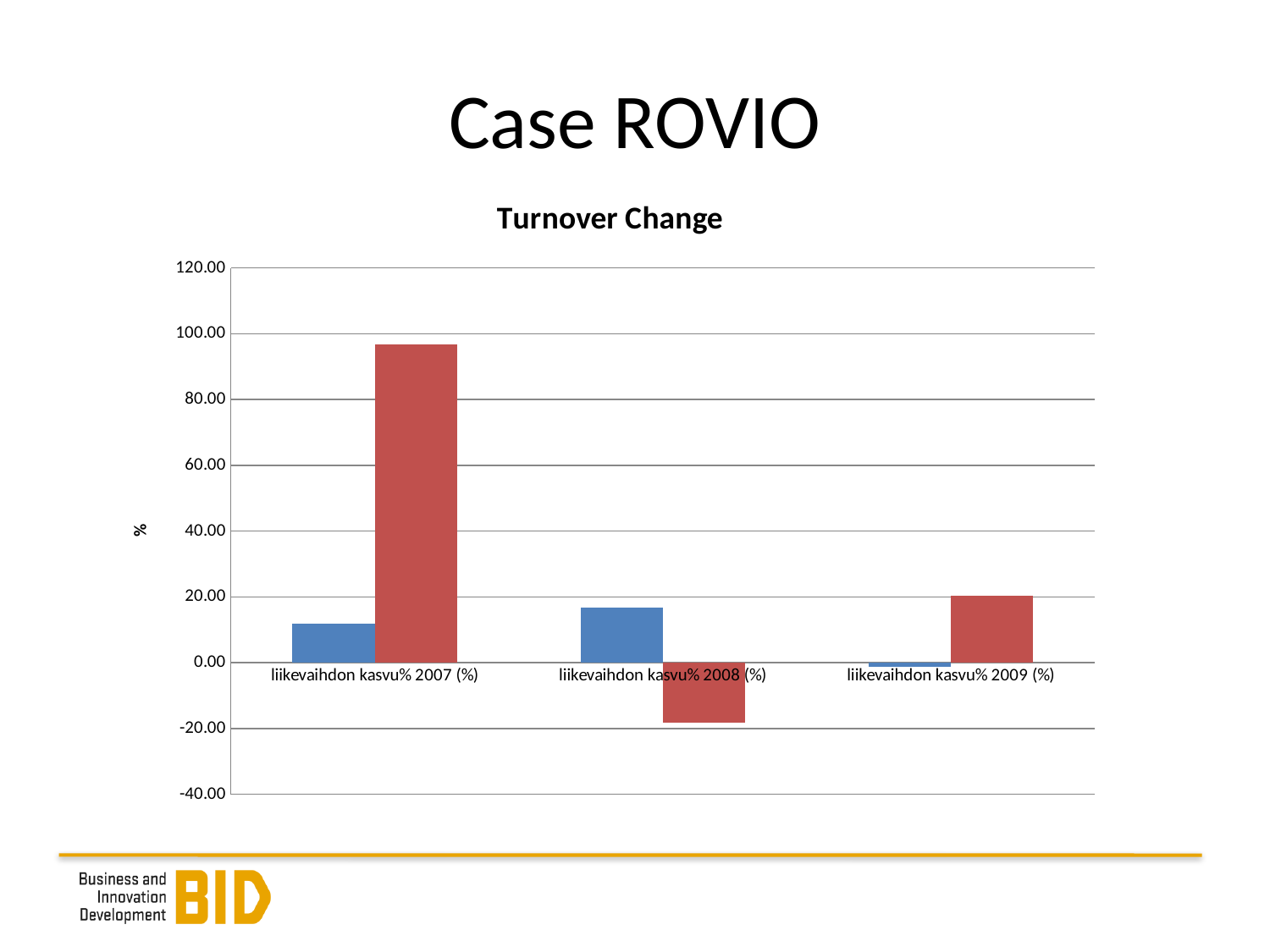
Which category contains the lowest bar in the Turnover Change chart? liikevaihdon kasvu% 2008 (%) What label is shown on the y axis of the Turnover Change chart? % Is the red bar for liikevaihdon kasvu% 2008 (%) greater or less than 0.00? less How many categories are shown on the x axis of the Turnover Change chart? 3 What is the title of the chart? Turnover Change Is the blue bar for liikevaihdon kasvu% 2008 (%) greater or less than 20.00? less What type of chart is shown on the slide? bar chart Is the red bar for liikevaihdon kasvu% 2007 (%) greater or less than 80.00? greater Which is larger in the Turnover Change chart: the red bar for liikevaihdon kasvu% 2007 (%) or the red bar for liikevaihdon kasvu% 2009 (%)? liikevaihdon kasvu% 2007 (%) Which is larger for liikevaihdon kasvu% 2008 (%): the blue bar or the red bar? the blue bar Which category has the tallest bar in the Turnover Change chart? liikevaihdon kasvu% 2007 (%) How many bars are plotted for each category in the Turnover Change chart? 2